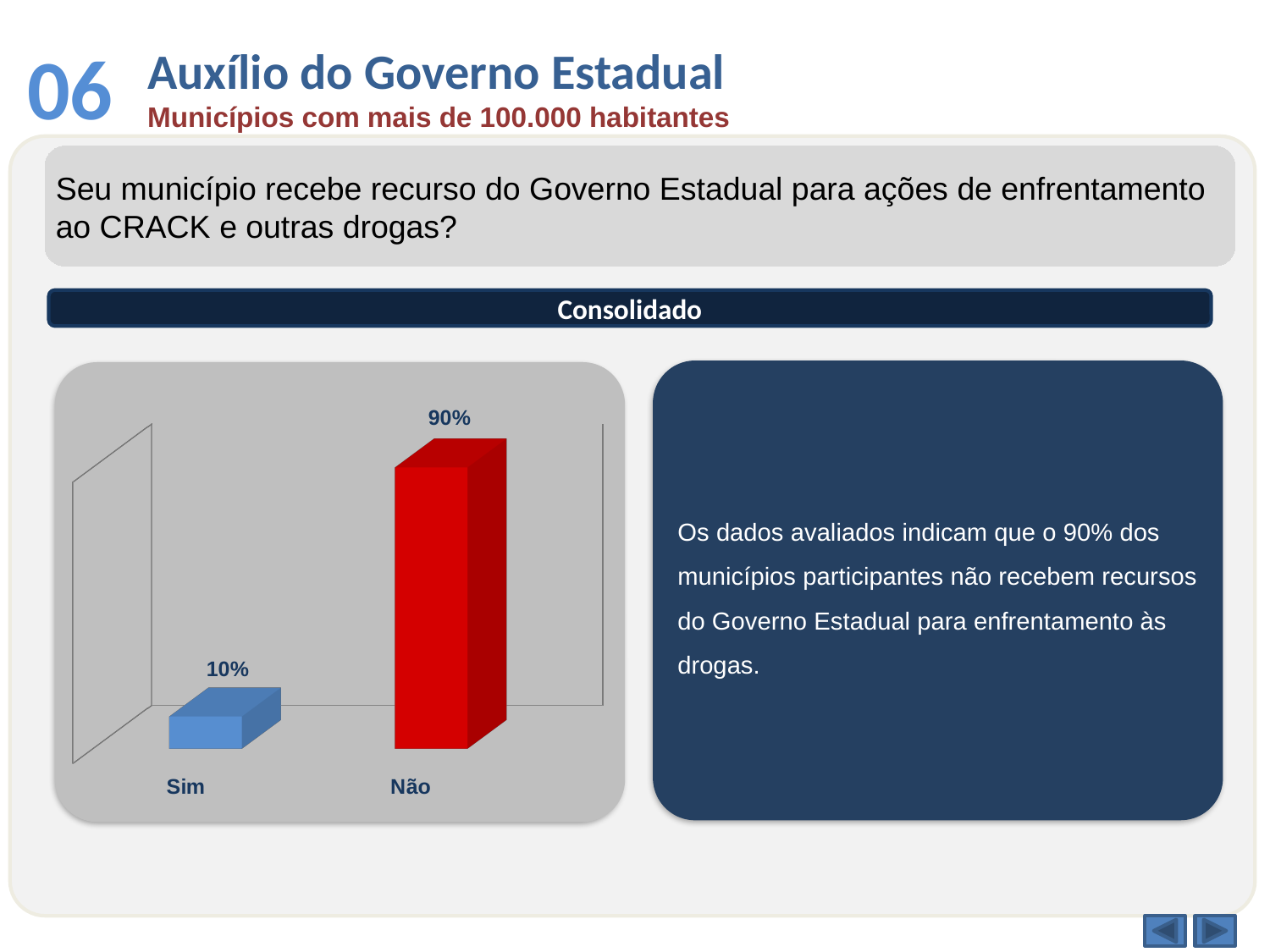
What is the difference between the values for Não and Sim? 80% Which category has the highest value? Não What kind of chart is shown on the slide? bar chart What is the value for Sim? 10% How many categories are shown in the chart? 2 Which category has the lowest value? Sim What is the total of the values for Sim and Não? 100% What colour is the bar for Não? red What is the value for Não? 90% Which is larger, the value for Sim or the value for Não? Não What colour is the bar for Sim? blue